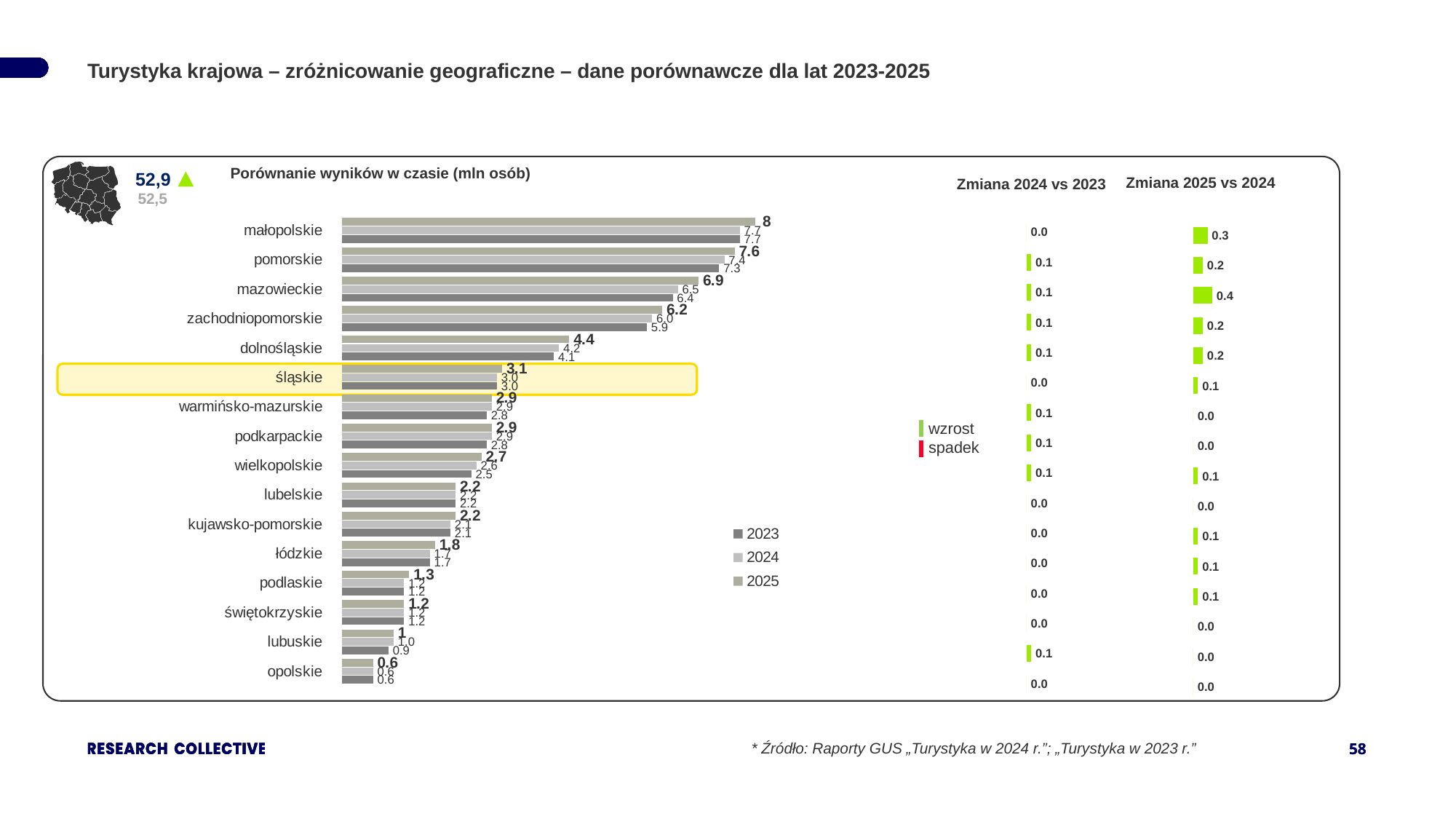
How many regions are listed in the chart 'Porównanie wyników w czasie (mln osób)'? 16 In the chart 'Porównanie wyników w czasie (mln osób)', which region has the highest 2025 value? małopolskie In the chart 'Porównanie wyników w czasie (mln osób)', which region has the lowest 2025 value? opolskie In the 'Zmiana 2024 vs 2023' chart, what is the value for lubuskie? 0.1 In the 'Zmiana 2025 vs 2024' chart, what is the value for mazowieckie? 0.4 What kind of chart is 'Porównanie wyników w czasie (mln osób)'? bar chart In the chart 'Porównanie wyników w czasie (mln osób)', which is larger: the 2025 value for zachodniopomorskie or for dolnośląskie? zachodniopomorskie In the chart 'Porównanie wyników w czasie (mln osób)', what is the difference between the 2025 values for małopolskie and pomorskie? 0.4 In the chart 'Porównanie wyników w czasie (mln osób)', what is the 2023 value for pomorskie? 7.3 How many series does the legend of the chart 'Porównanie wyników w czasie (mln osób)' list? 3 In the chart 'Porównanie wyników w czasie (mln osób)', what is the 2025 value for małopolskie? 8 In the chart 'Porównanie wyników w czasie (mln osób)', what is the 2025 value for mazowieckie? 6.9